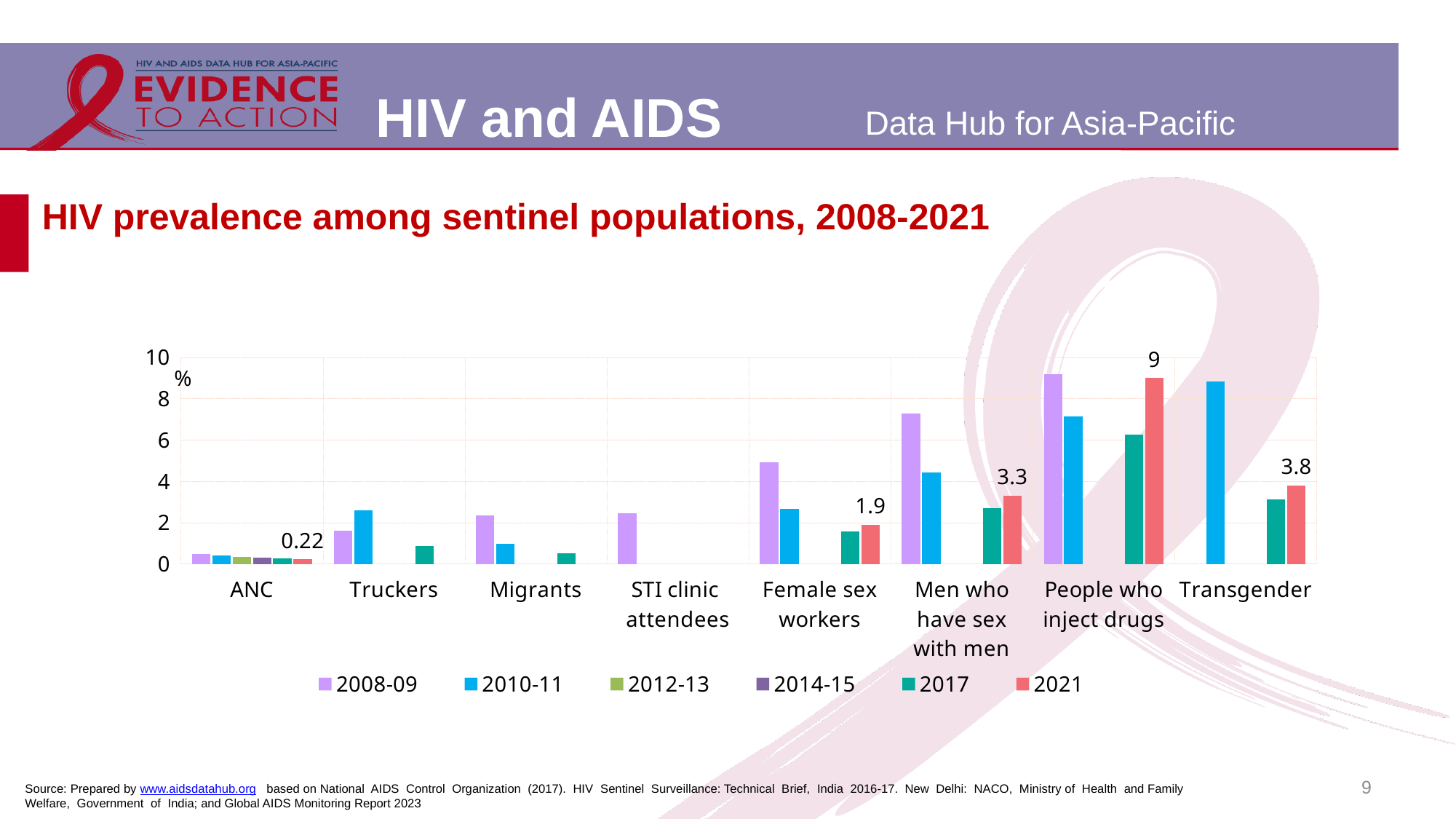
What is the 2021 HIV prevalence value shown for People who inject drugs? 9 How many series does the legend list? 6 Among the 2021 values labelled on the chart, which population has the highest value? People who inject drugs In 2021, which is larger: the value for Transgender or for Men who have sex with men? Transgender Is the 2010-11 value for Transgender greater or less than 8? greater What is the difference between the 2021 values for People who inject drugs and Transgender? 5.2 What is the 2021 value shown for ANC? 0.22 Is the 2008-09 value for STI clinic attendees greater or less than 4? less Among the 2021 values labelled on the chart, which population has the lowest value? ANC How many population categories are shown on the x axis? 8 What is the 2021 value shown for Men who have sex with men? 3.3 What is the 2021 value shown for Transgender? 3.8